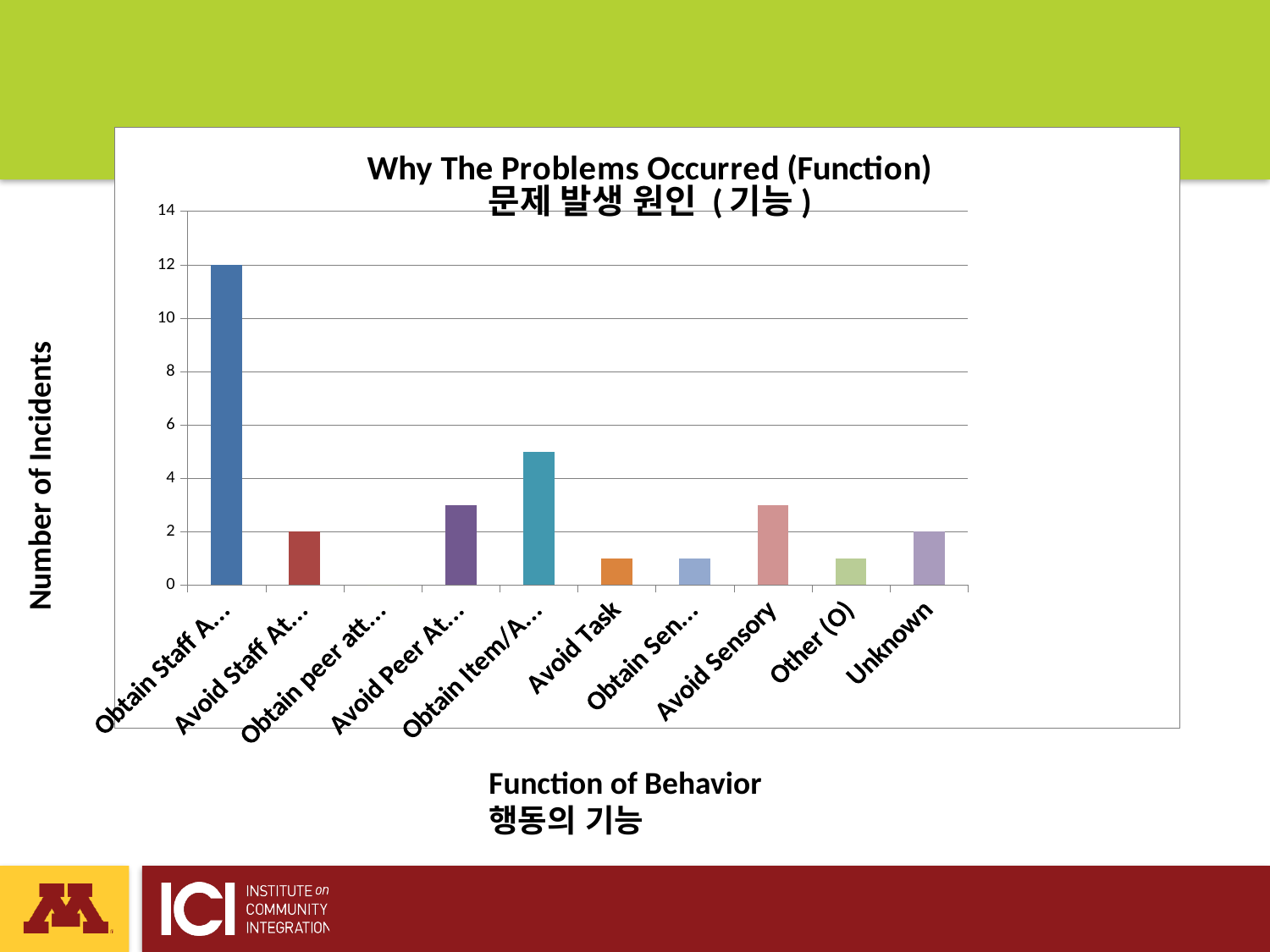
What is the difference in incidents between Obtain Staff A... and Unknown? 10 Which category has the highest number of incidents? Obtain Staff A... What kind of chart is shown on the slide? bar chart What is the label of the vertical axis? Number of Incidents Is the value for Avoid Sensory greater or less than 2? greater What is the number of incidents for Unknown? 2 What is the title of the chart? Why The Problems Occurred (Function) What is the number of incidents for the first category, Obtain Staff A...? 12 Which has more incidents, Avoid Sensory or Other (O)? Avoid Sensory Is the value for Avoid Task greater or less than 2? less Which has more incidents, Unknown or Avoid Task? Unknown How many categories are shown on the x axis? 10